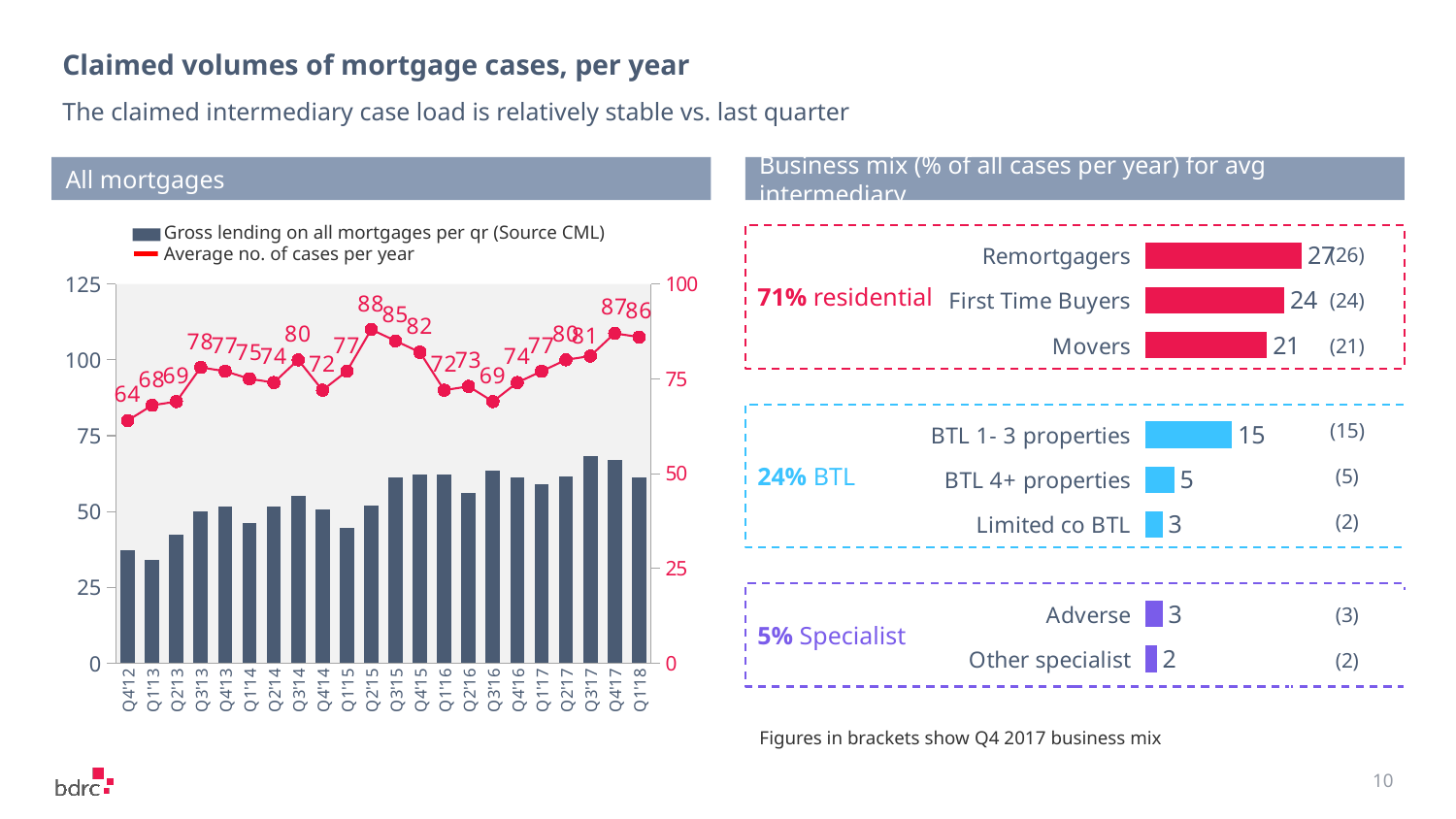
In the 'Business mix' chart, which category has the highest value? Remortgagers How many series does the legend of the 'All mortgages' chart list? 2 In the 'All mortgages' chart, which quarter has the highest average number of cases per year? Q2'15 In the 'Business mix' chart, what percentage of cases is shown for Remortgagers? 27 In the 'Business mix' chart, what is the difference between the values for BTL 1- 3 properties and BTL 4+ properties? 10 In the 'All mortgages' chart, what is the difference between the average number of cases per year for Q4'17 and Q1'18? 1 In the 'All mortgages' chart, what is the average number of cases per year for Q1'18? 86 In the 'All mortgages' chart, which quarter has the lowest average number of cases per year? Q4'12 How many quarters are plotted on the x axis of the 'All mortgages' chart? 22 In the 'All mortgages' chart, what is the average number of cases per year shown for Q2'15? 88 In the 'All mortgages' chart, is the gross lending bar for Q4'12 greater or less than 50? less What kind of chart is the 'Business mix' chart on the right? Bar chart